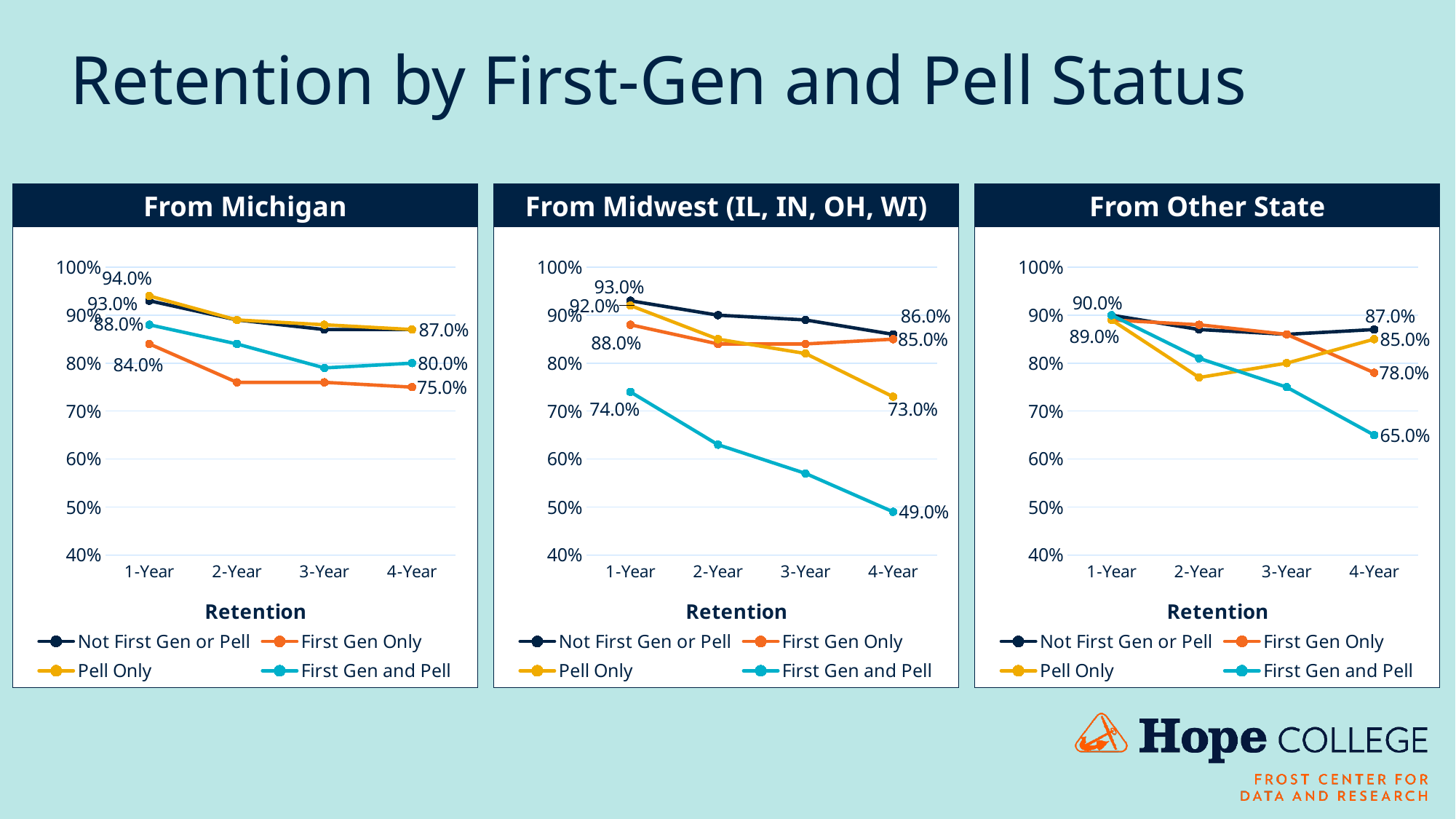
In the 'From Midwest (IL, IN, OH, WI)' chart, does First Gen and Pell retention rise or fall from 1-Year to 4-Year? Fall How many series does the legend of the 'From Other State' chart list? 4 In the 'From Midwest (IL, IN, OH, WI)' chart, what is the difference between the 4-Year retention of Not First Gen or Pell and First Gen and Pell? 37.0 percentage points In the 'From Midwest (IL, IN, OH, WI)' chart, which series has the lowest 4-Year retention? First Gen and Pell In the 'From Other State' chart, what is the 4-Year retention value for Not First Gen or Pell? 87.0% In the 'From Other State' chart, what is the 4-Year retention value for First Gen and Pell? 65.0% In the 'From Michigan' chart, by how much does First Gen and Pell retention drop from 1-Year to 4-Year? 8.0 percentage points What kind of chart is used in the 'From Michigan' panel? Line chart In the 'From Midwest (IL, IN, OH, WI)' chart, what is the 1-Year retention value for First Gen and Pell? 74.0% In the 'From Michigan' chart, what is the 4-Year retention value for First Gen Only? 75.0% In the 'From Midwest (IL, IN, OH, WI)' chart, what is the 4-Year retention value for First Gen and Pell? 49.0% In the 'From Other State' chart, is the 2-Year retention value for Pell Only greater or less than 80%? less